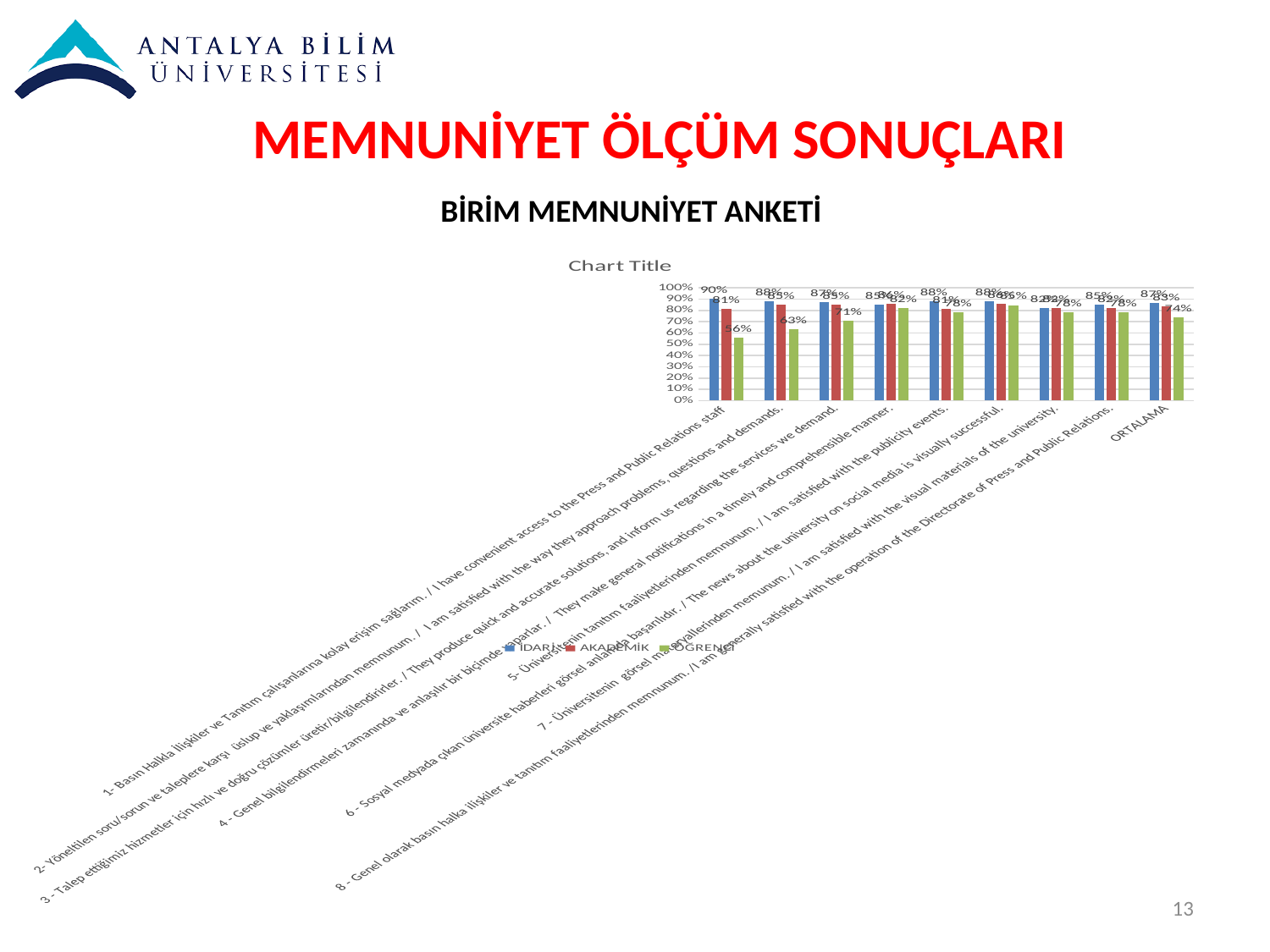
What is the İDARİ value for category 1 (Basın Halkla İlişkiler ve Tanıtım çalışanlarına kolay erişim sağlarım)? 90% Is the ÖĞRENCİ value for category 2 (Yöneltilen soru/sorun ve taleplere karşı üslup ve yaklaşımlarından memnunum) greater or less than 70%? less What are the three series names shown in the chart legend? İDARİ, AKADEMİK, ÖĞRENCİ For category 1, which is larger: the İDARİ value or the ÖĞRENCİ value? İDARİ How many series does the chart legend list? 3 What is the ÖĞRENCİ value for category 1 (Basın Halkla İlişkiler ve Tanıtım çalışanlarına kolay erişim sağlarım)? 56% What is the AKADEMİK value for category 1 (Basın Halkla İlişkiler ve Tanıtım çalışanlarına kolay erişim sağlarım)? 81% What kind of chart is shown on the slide? bar chart How many categories are plotted along the x axis of the chart (including ORTALAMA)? 9 What is the ÖĞRENCİ value for ORTALAMA? 74% What is the difference between the İDARİ and ÖĞRENCİ values for category 1? 34 percentage points Which category has the lowest ÖĞRENCİ value? Category 1 (Basın Halkla İlişkiler ve Tanıtım çalışanlarına kolay erişim sağlarım)